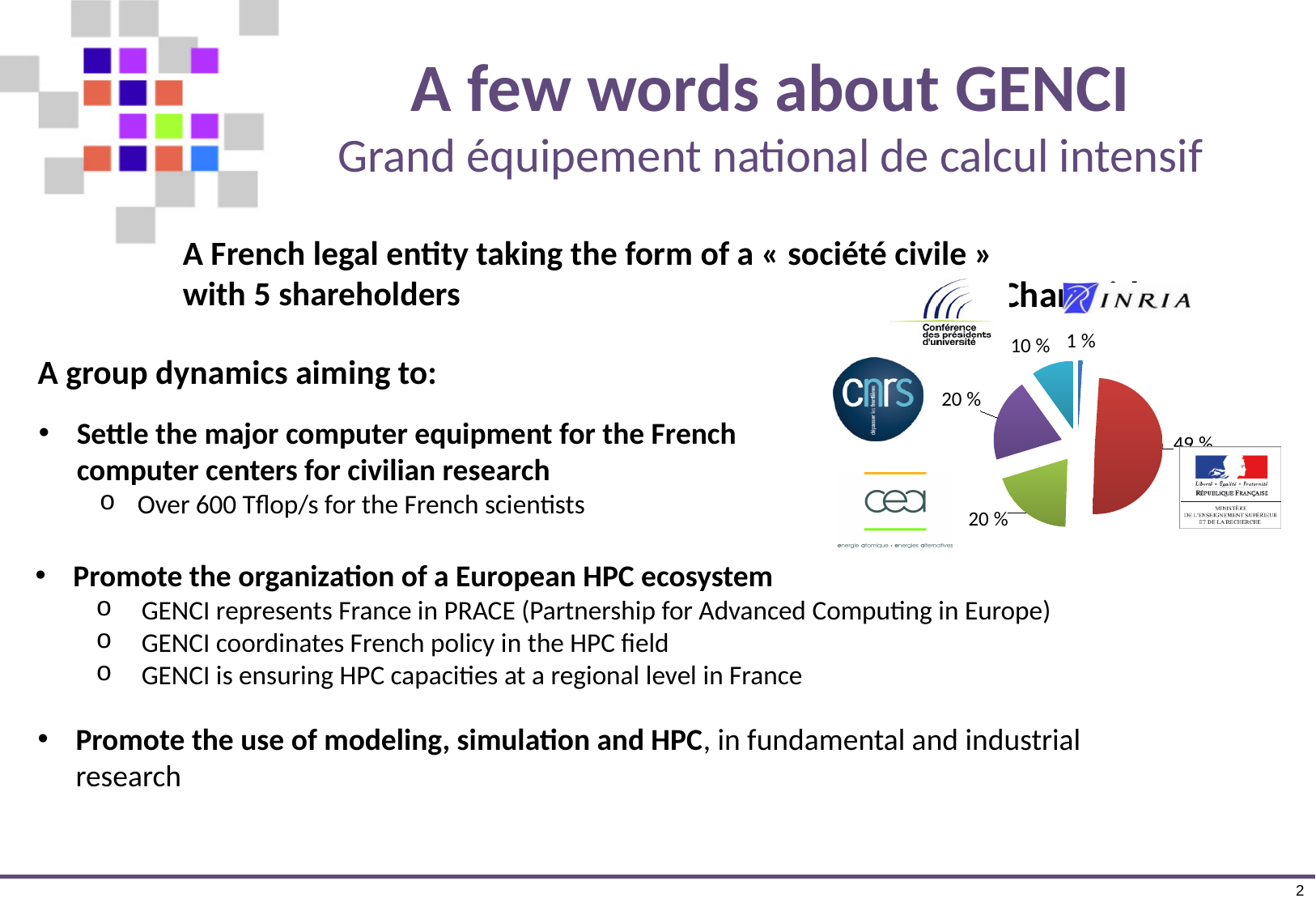
Is the red slice of the pie chart greater or less than 40 %? greater What is the value of the largest slice of the pie chart? 49 % What is the value of the smallest slice of the pie chart? 1 % What is the difference between the largest slice (49 %) and the 10 % slice? 39 % What is the value of the red slice of the pie chart? 49 % How many slices of the pie chart are labelled 20 %? 2 What is the value of the light blue slice of the pie chart? 10 % What kind of chart is shown on the slide? pie chart What is the value of the green slice of the pie chart? 20 % How many slices does the pie chart have? 5 What is the difference between the 10 % slice and the 1 % slice? 9 % Which is larger, the red slice or the green slice of the pie chart? the red slice